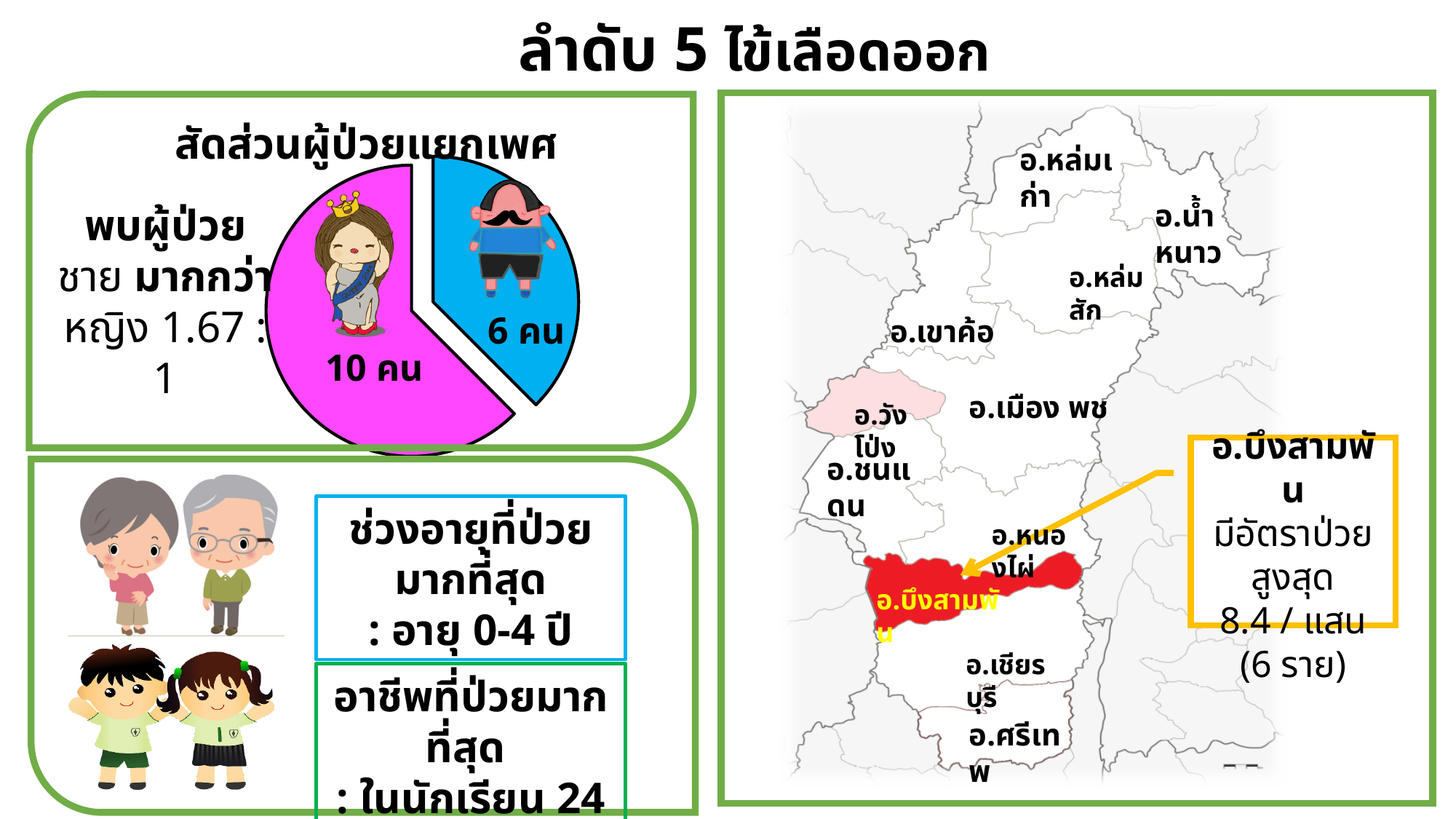
Which slice of the pie chart is the smallest? the blue slice (6 คน) What is the title of the pie chart? สัดส่วนผู้ป่วยแยกเพศ What share of the pie chart does the 10 คน slice represent? 62.5% Which slice of the pie chart is the largest? the magenta slice (10 คน) What two colours are used for the slices of the pie chart? magenta and blue How many slices does the pie chart have? 2 In the pie chart, what value is printed on the magenta slice? 10 คน In the pie chart, what value is printed on the blue slice? 6 คน In the pie chart, how many more people does the magenta slice represent than the blue slice? 4 คน What is the total number of people represented by both slices of the pie chart? 16 คน What kind of chart is shown in the top-left box of the slide? pie chart In the pie chart, is the magenta slice or the blue slice larger? the magenta slice